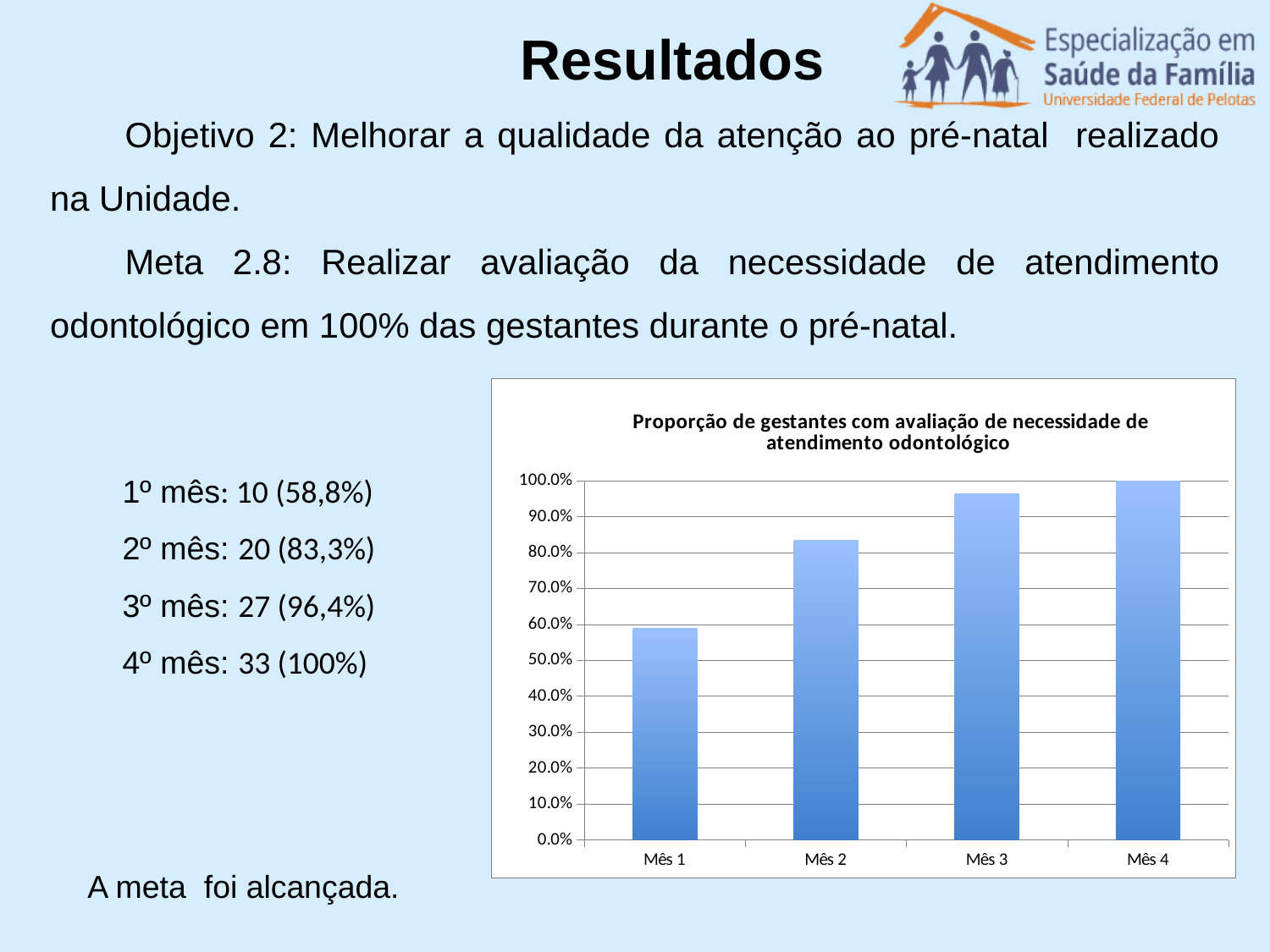
Which is larger, the value for Mês 2 or the value for Mês 3? Mês 3 What kind of chart is shown on the slide? bar chart What is the title of the chart? Proporção de gestantes com avaliação de necessidade de atendimento odontológico What value does the bar for Mês 4 reach on the axis? 100.0% Do the values rise or fall from Mês 1 to Mês 4? rise Is the value for Mês 3 greater or less than 90.0%? greater Which month has the lowest proportion on the chart? Mês 1 Is the value for Mês 1 greater or less than 50.0%? greater Is the value for Mês 1 greater or less than 60.0%? less How many months (categories) are plotted on the chart? 4 Which month has the highest proportion on the chart? Mês 4